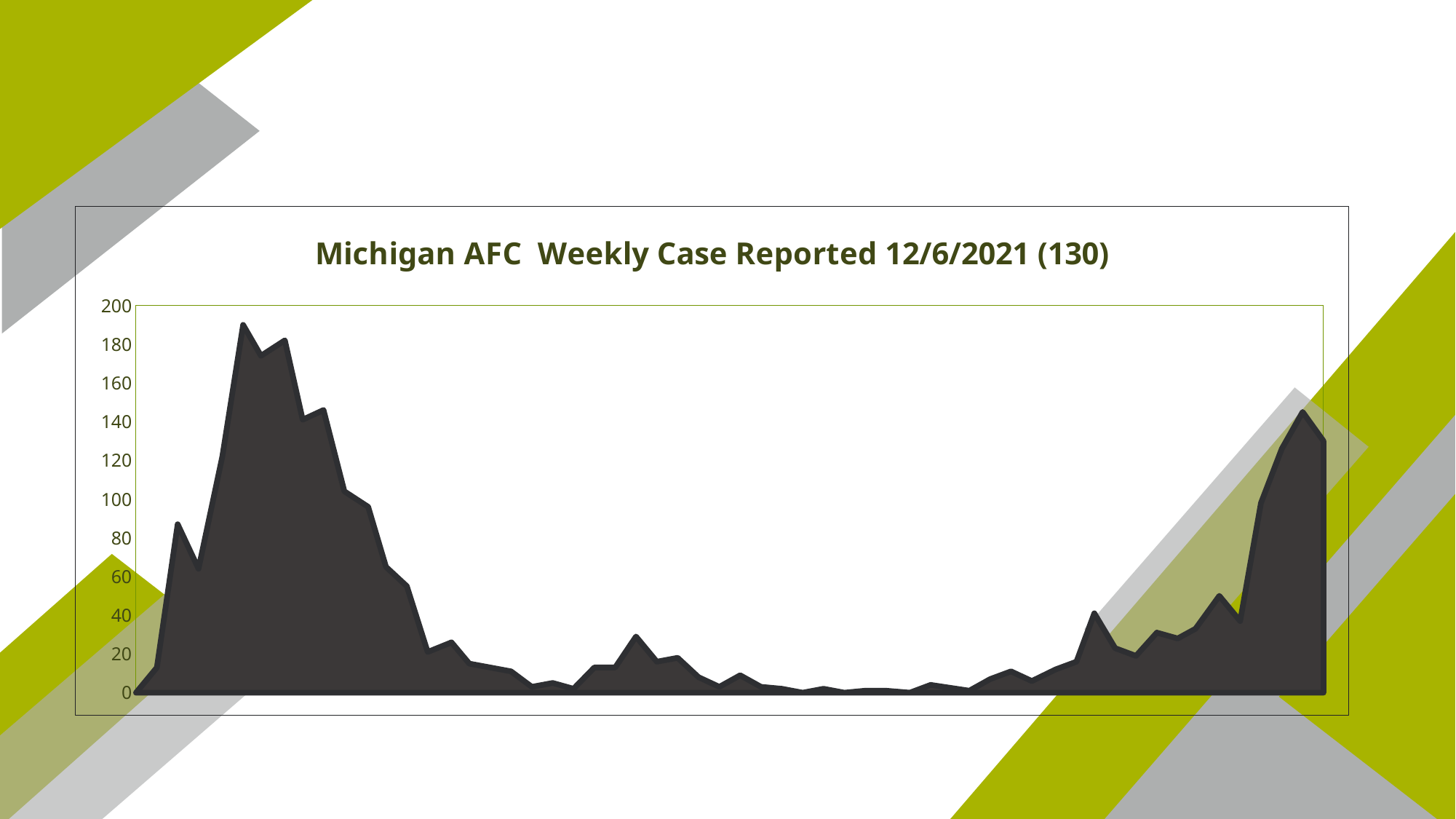
Is the peak near the right end of the chart greater or less than 120? greater Which is higher, the peak on the left side of the chart or the peak on the right side? The peak on the left side Are the values in the middle section of the chart greater or less than 40? less Do the values rise or fall from the left peak toward the middle of the chart? fall What kind of chart is shown on the slide? Area chart Is the highest peak of the chart greater or less than 200? less What is the highest value labelled on the vertical axis? 200 What is the lowest value labelled on the vertical axis? 0 What is the title of the chart? Michigan AFC Weekly Case Reported 12/6/2021 (130) What number appears in parentheses at the end of the chart title? 130